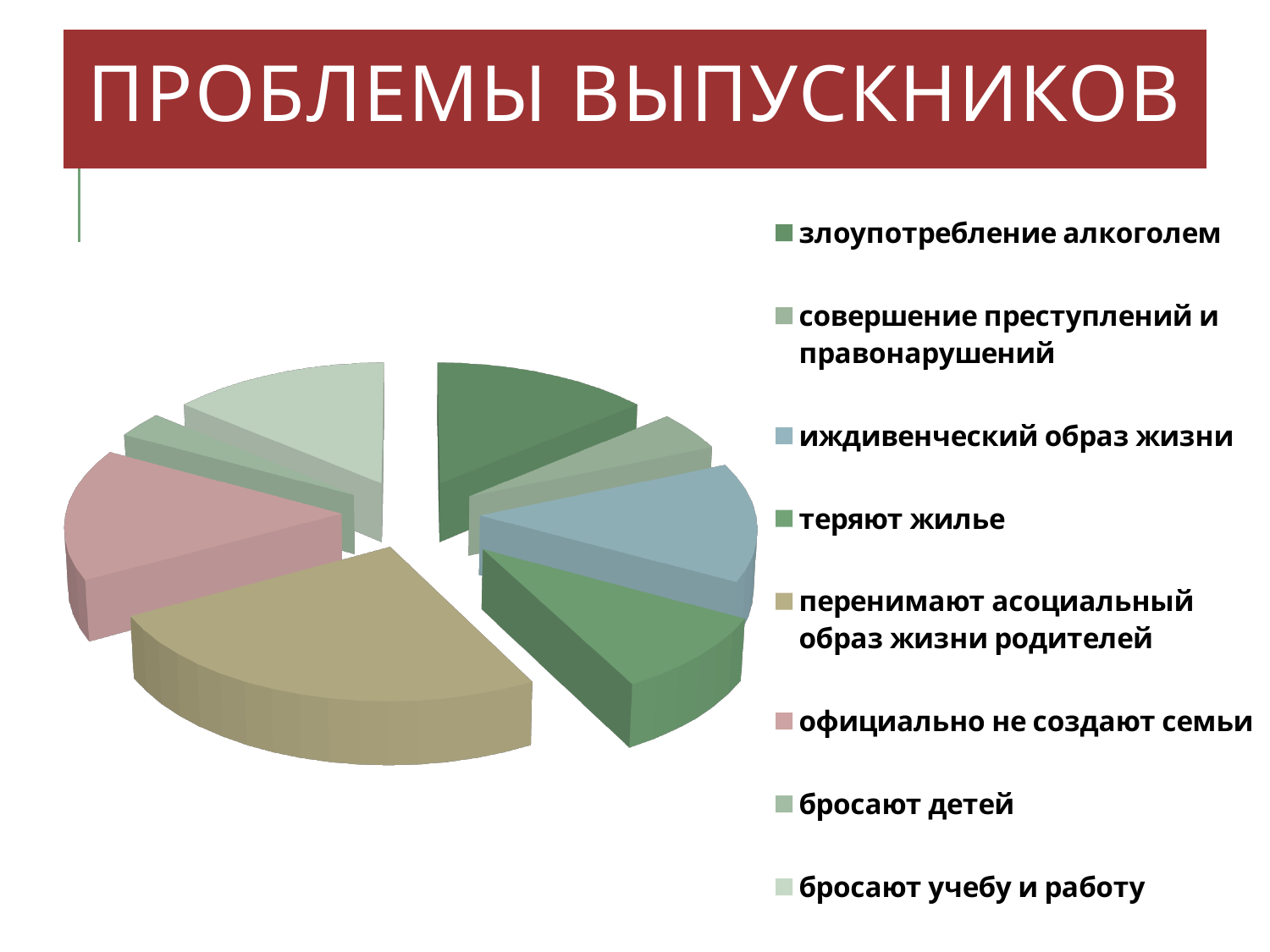
What is the title of the slide containing the pie chart? ПРОБЛЕМЫ ВЫПУСКНИКОВ What kind of chart is shown on the slide? pie chart How many categories does the legend of the pie chart list? 8 Which slice is larger: "перенимают асоциальный образ жизни родителей" or "официально не создают семьи"? перенимают асоциальный образ жизни родителей Which slice is larger: "теряют жилье" or "бросают детей"? теряют жилье Which slice is larger: "иждивенческий образ жизни" or "совершение преступлений и правонарушений"? иждивенческий образ жизни Which category is listed first in the legend of the pie chart? злоупотребление алкоголем Which category has the largest slice in the pie chart? перенимают асоциальный образ жизни родителей Which legend entry is shown in pink in the pie chart? официально не создают семьи